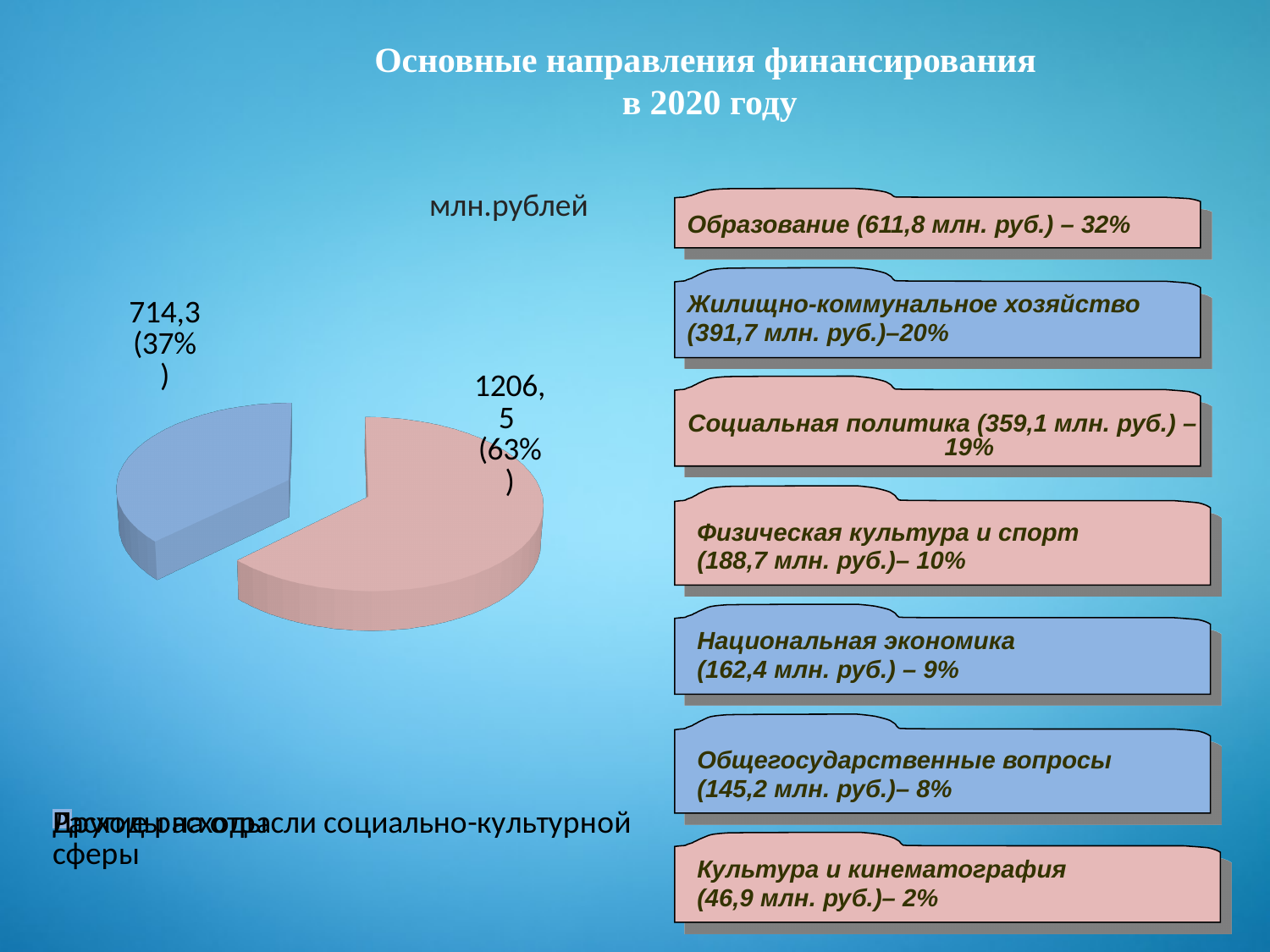
What is the title of the slide containing the pie chart? Основные направления финансирования в 2020 году Which is larger: the value of the blue slice or the value of the pink slice? the pink slice What unit is indicated above the pie chart? млн.рублей Which slice of the pie chart is the largest, the pink one or the blue one? the pink one What value is printed on the larger (pink) slice of the pie chart? 1206,5 What value is printed on the smaller (blue) slice of the pie chart? 714,3 What kind of chart is shown on the slide? pie chart How many slices does the pie chart have? 2 What share of the pie does the blue slice represent? 37% What is the difference between the values of the pink slice (1206,5) and the blue slice (714,3)? 492,2 What share of the pie does the pink slice represent? 63%